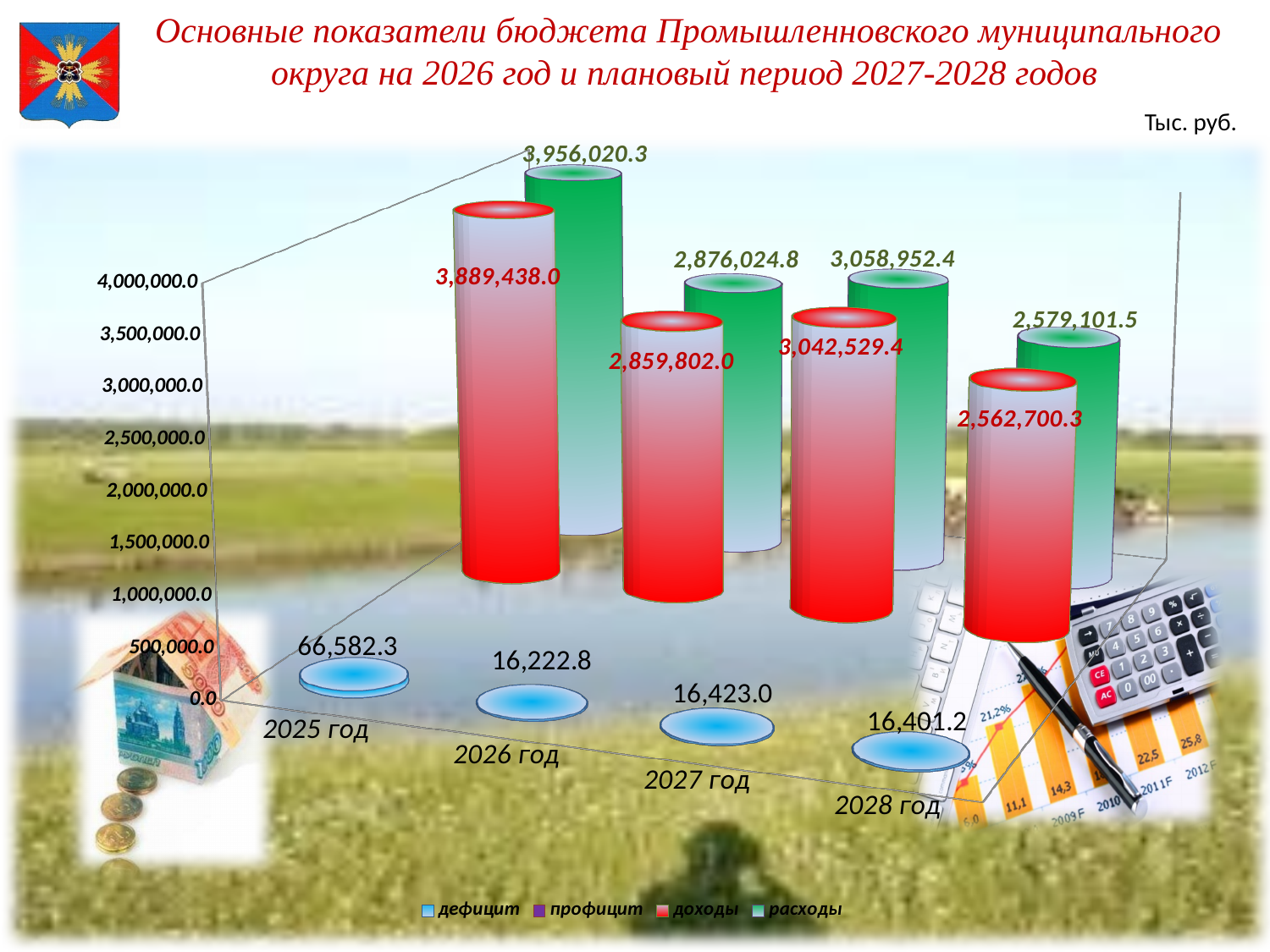
What unit of measurement is indicated for the chart values? Тыс. руб. What is the value of расходы for 2028 год? 2,579,101.5 How many series does the chart legend list? 4 Is the value of доходы for 2026 год greater or less than 3,000,000.0? less What is the value of дефицит for 2027 год? 16,423.0 What is the value of расходы for 2026 год? 2,876,024.8 Which is larger for 2027 год: доходы or расходы? расходы What is the value of доходы for 2025 год? 3,889,438.0 How many years are shown on the x axis of the chart? 4 What is the difference between расходы and доходы for 2025 год? 66,582.3 In which year is доходы the highest? 2025 год In which year is расходы the lowest? 2028 год